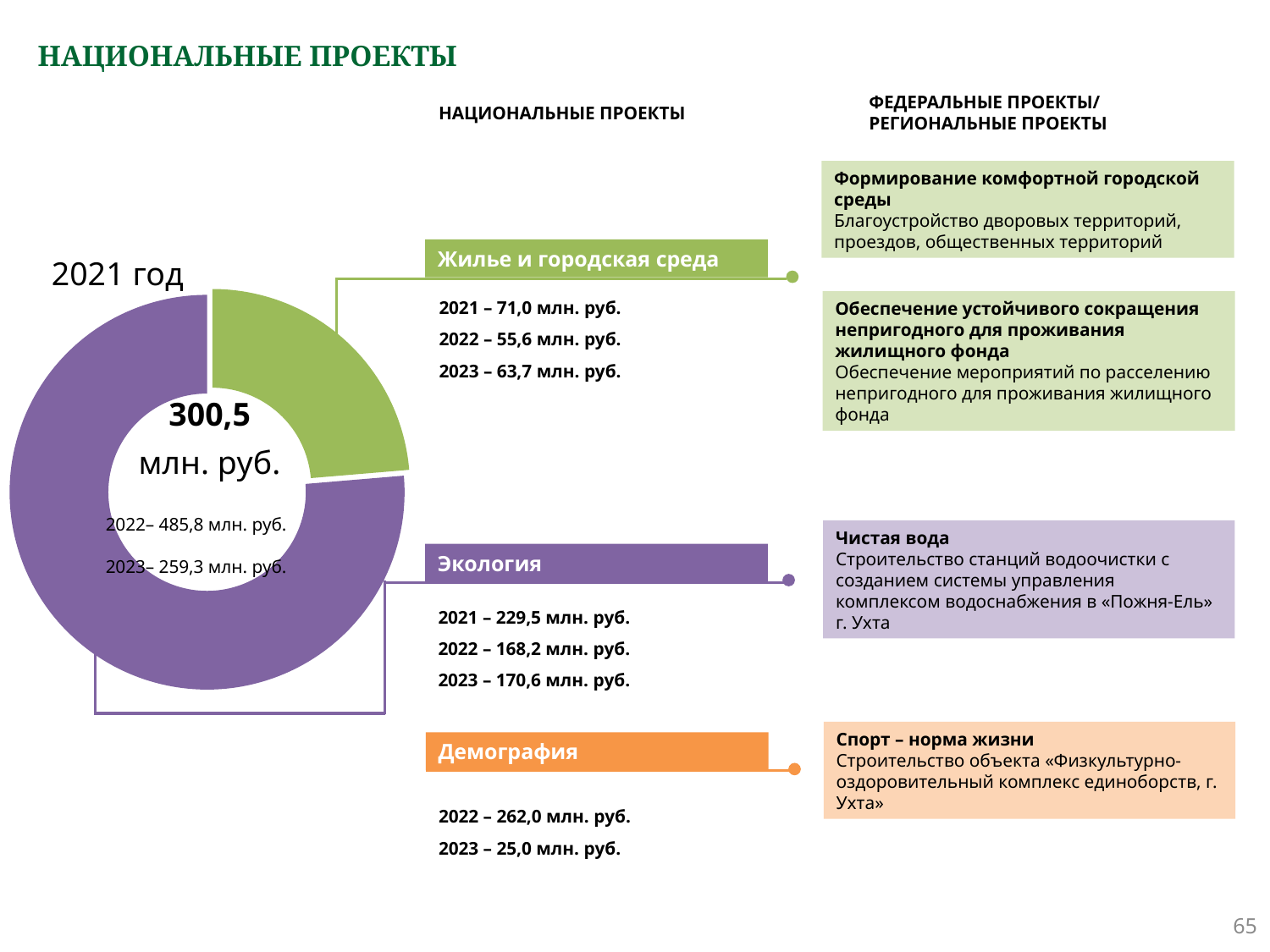
Which national project has the smallest slice in the donut chart? Жилье и городская среда Which year does the donut chart represent? 2021 год What is the 2021 value for Экология? 229,5 млн. руб. What colour is the Экология slice in the donut chart? purple What is the 2021 value for Жилье и городская среда? 71,0 млн. руб. What share of the 300,5 млн. руб. total does Жилье и городская среда (71,0 млн. руб.) represent? 23,6% By how much does the 2021 value for Экология exceed the 2021 value for Жилье и городская среда? 158,5 млн. руб. What total value is shown in the centre of the donut chart? 300,5 млн. руб. Which is larger in 2021: Экология or Жилье и городская среда? Экология What kind of chart is shown on the slide? pie chart (donut) Which national project has the largest slice in the donut chart? Экология How many slices does the donut chart have? 2